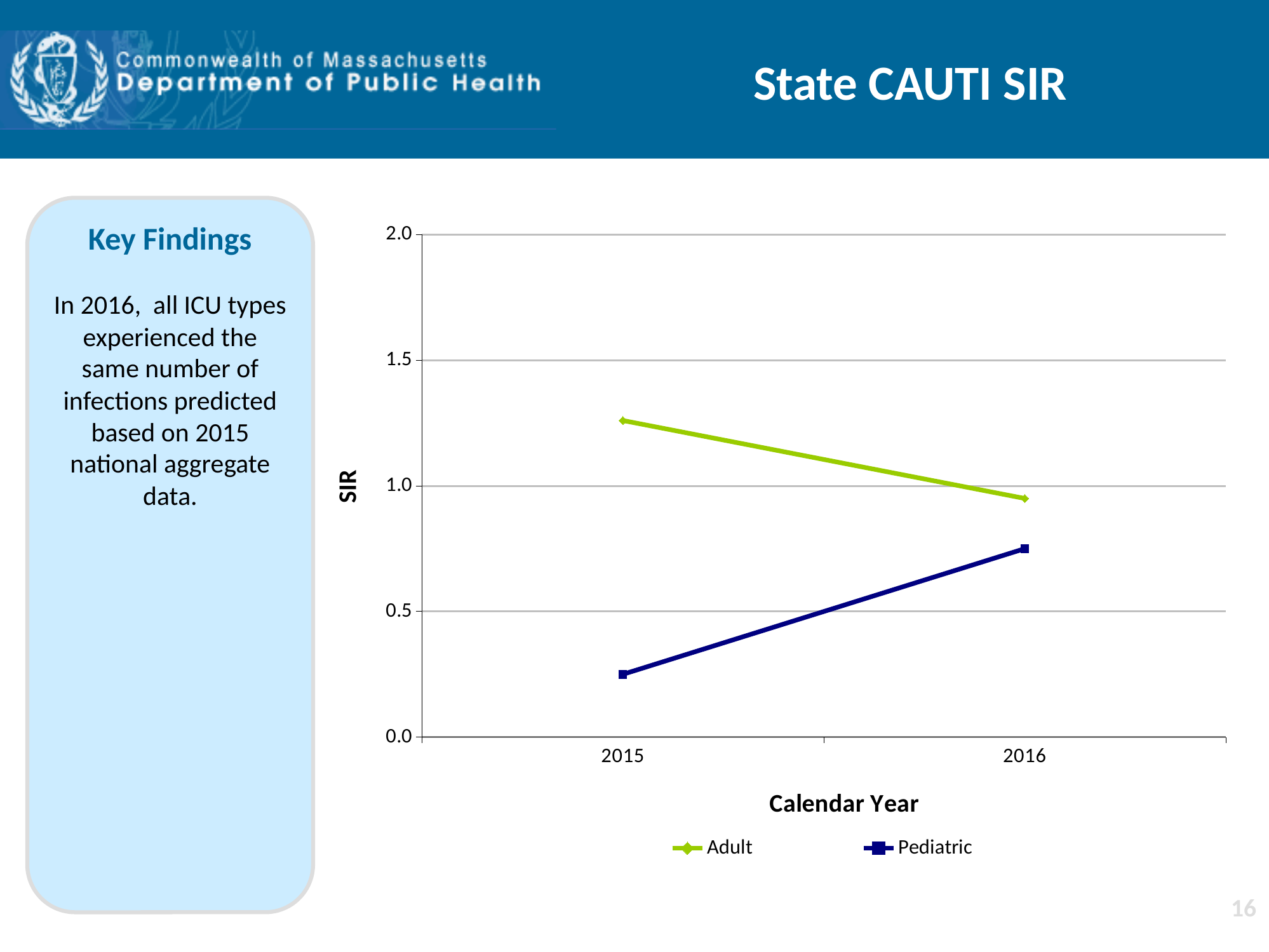
What is the label of the y axis? SIR Is the Adult SIR in 2015 greater or less than 1.0? greater How many series does the legend list? 2 Does the Pediatric SIR rise or fall from 2015 to 2016? rise Is the Adult SIR in 2016 greater or less than 1.5? less How many calendar years are plotted on the x axis? 2 Which series is drawn in green? Adult Is the Pediatric SIR in 2015 greater or less than 0.5? less What kind of chart is shown on the slide? line chart Does the Adult SIR rise or fall from 2015 to 2016? fall In 2015, which series has the higher SIR, Adult or Pediatric? Adult